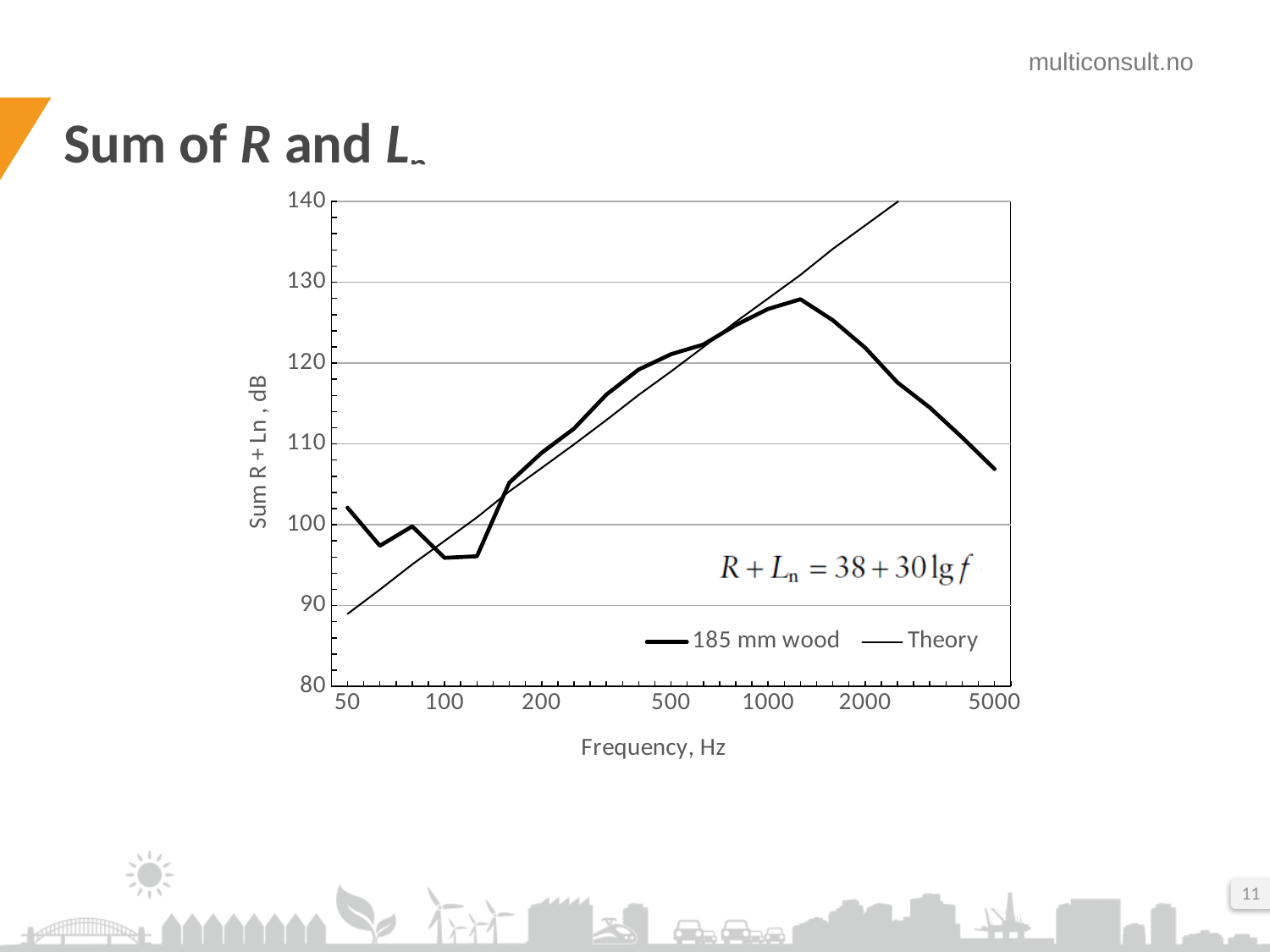
Is the value of the 185 mm wood series at 5000 Hz greater or less than 110? less Is the value of the 185 mm wood series at 100 Hz greater or less than 100? less Is the value of the Theory series at 50 Hz greater or less than 90? less What are the two series named in the legend? 185 mm wood and Theory At 2000 Hz, which series has the higher value, 185 mm wood or Theory? Theory How many series does the legend list? 2 What is the label of the x axis? Frequency, Hz What kind of chart is shown on the slide? line chart At 50 Hz, which series has the higher value, 185 mm wood or Theory? 185 mm wood